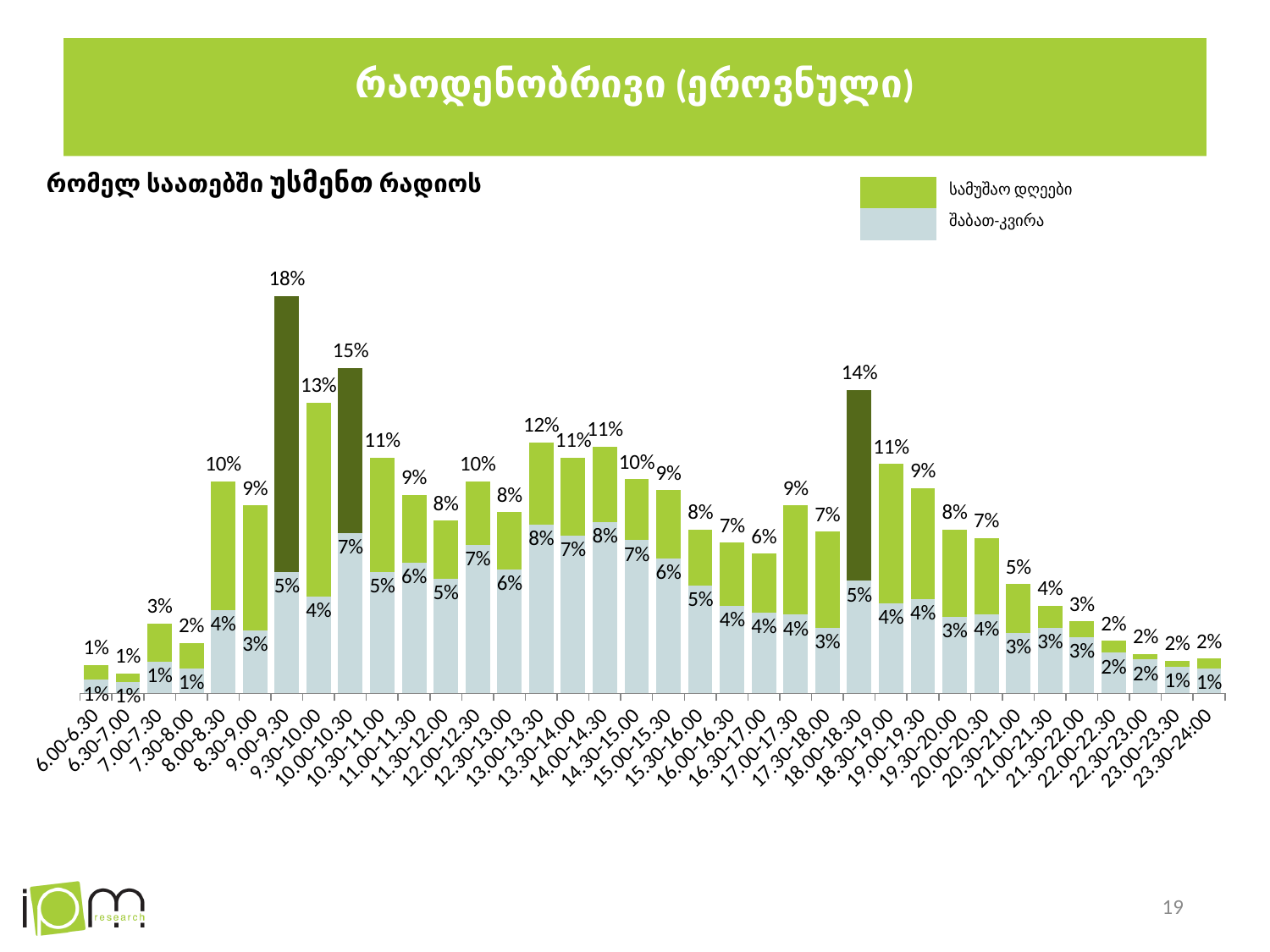
What value is printed at the top of the bar for 9.00-9.30? 18% How many series does the legend list? 2 Do the bar values rise or fall from 18.30-19.00 to 23.30-24.00? fall Which bar is taller: 9.00-9.30 or 18.00-18.30? 9.00-9.30 What is the შაბათ-კვირა (weekend) value shown for 18.00-18.30? 5% What kind of chart is shown on the slide? bar chart How many time slots (categories) are shown on the x axis? 36 Which time slot has the tallest bar? 9.00-9.30 What is the შაბათ-კვირა (weekend) value shown for 10.00-10.30? 7% What is the difference between the top labels of the 9.00-9.30 bar (18%) and the 9.30-10.00 bar (13%)? 5 percentage points What are the two legend entries of the chart? სამუშაო დღეები and შაბათ-კვირა What value is printed at the top of the bar for 18.00-18.30? 14%